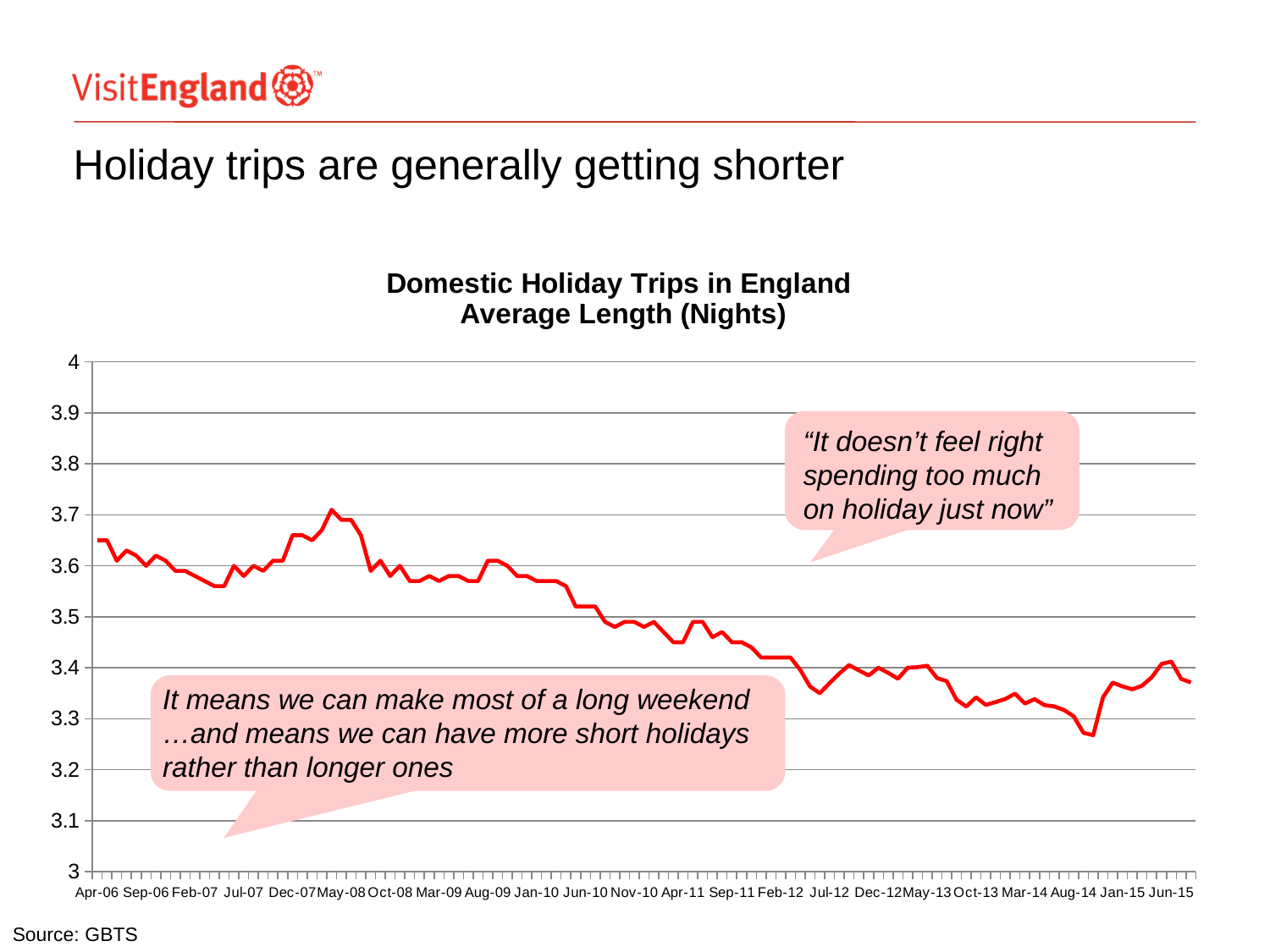
Which is larger, the value for Apr-06 or the value for Jun-15? Apr-06 How many date labels are shown along the x axis? 23 Is the value for Jul-12 greater or less than 3.4? less What is the range of the y axis? 3 to 4 Is the value for Apr-06 greater or less than 3.6? greater Is the value for Jan-10 greater or less than 3.5? greater What kind of chart is shown on the slide? line chart Do the values in the chart generally rise or fall from Apr-06 to Jun-15? fall How many data series are plotted in the chart? 1 What is the title of the chart? Domestic Holiday Trips in England Average Length (Nights)